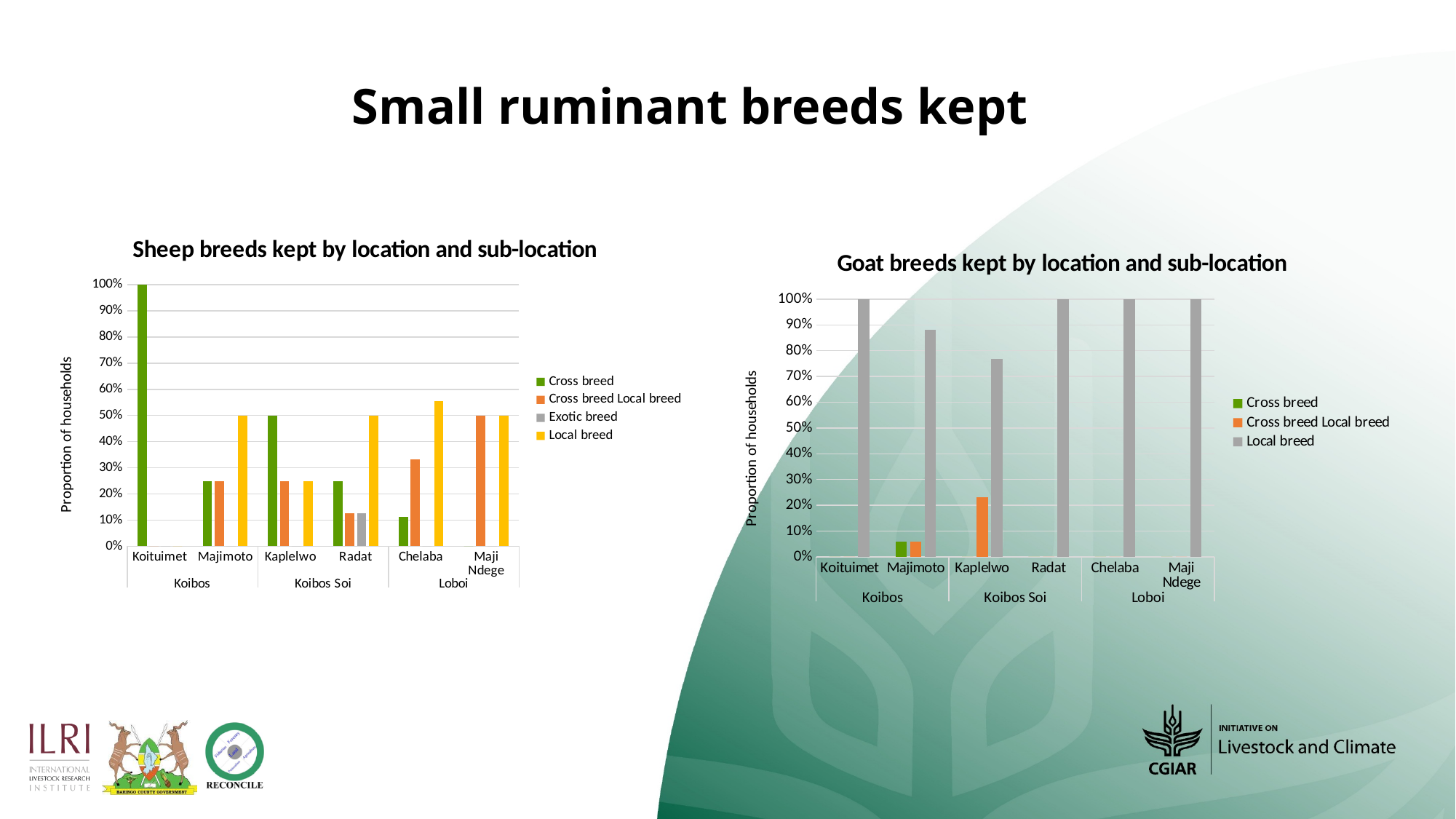
In the 'Goat breeds kept by location and sub-location' chart, is the Local breed value for Kaplelwo greater or less than 70%? greater In the 'Sheep breeds kept by location and sub-location' chart, which sub-location has the highest Cross breed value? Koituimet In the 'Sheep breeds kept by location and sub-location' chart, how many series does the legend list? 4 In the 'Goat breeds kept by location and sub-location' chart, what is the proportion of households with Local breed goats in Radat? 100% In the 'Sheep breeds kept by location and sub-location' chart, is the value for Cross breed Local breed in Chelaba greater or less than 30%? greater In the 'Goat breeds kept by location and sub-location' chart, what colour represents Local breed? grey What kind of chart is the 'Sheep breeds kept by location and sub-location' chart? bar chart In the 'Sheep breeds kept by location and sub-location' chart, which is larger in Radat: Cross breed or Local breed? Local breed In the 'Goat breeds kept by location and sub-location' chart, which sub-location has the lowest Local breed value? Kaplelwo In the 'Sheep breeds kept by location and sub-location' chart, how many sub-locations are shown on the x axis? 6 In the 'Sheep breeds kept by location and sub-location' chart, what is the proportion of households with Cross breed sheep in Koituimet? 100% In the 'Goat breeds kept by location and sub-location' chart, how many series does the legend list? 3